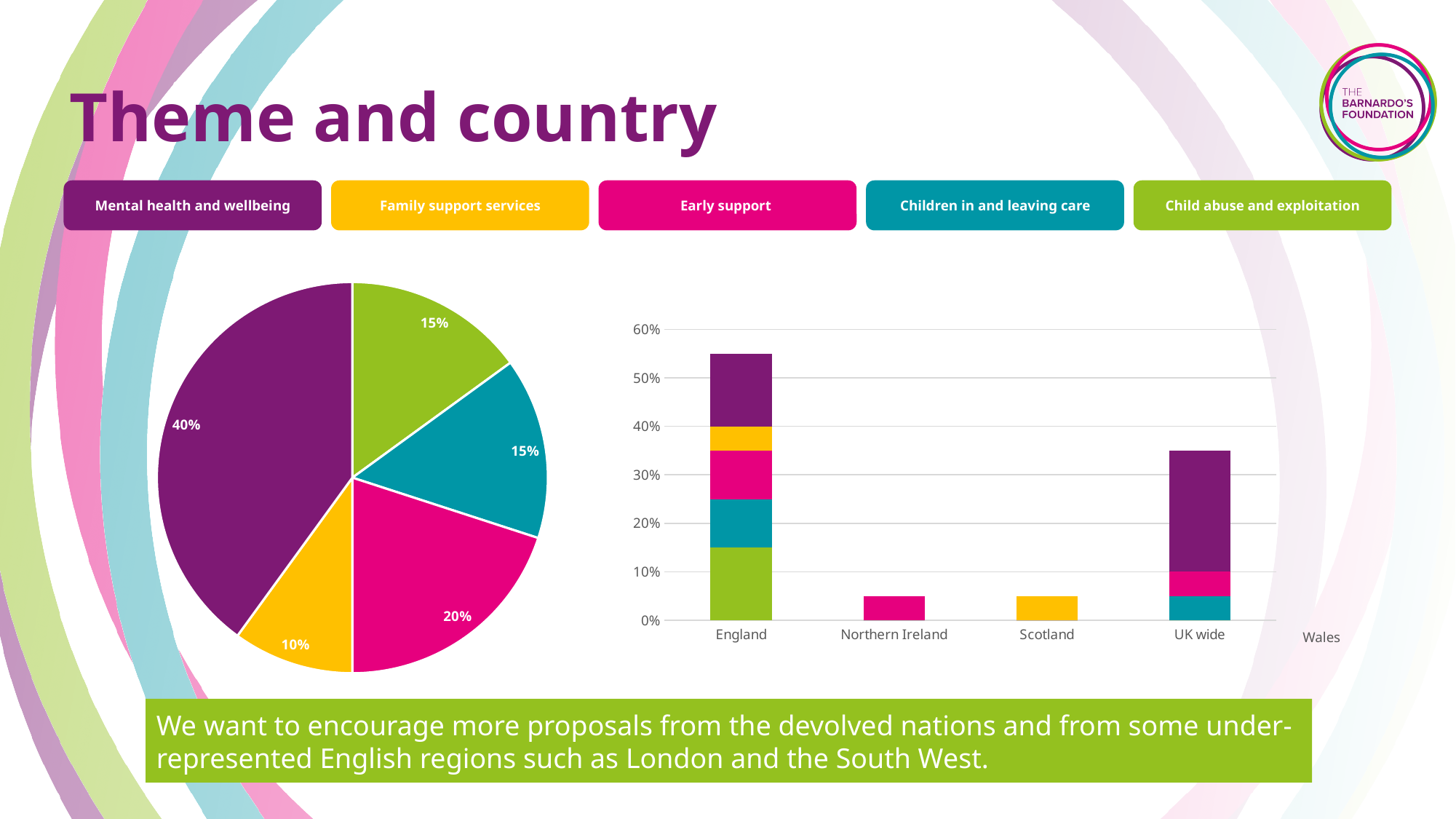
How many slices does the pie chart have? 5 In the pie chart, what share is shown for the purple slice (Mental health and wellbeing)? 40% How many countries are listed on the x axis of the bar chart on the right? 5 In the bar chart on the right, is the total for England greater or less than 50%? greater In the bar chart on the right, is the total for UK wide greater or less than 40%? less In the pie chart, which theme has the smallest share? Family support services In the pie chart, what share is shown for the yellow slice (Family support services)? 10% In the bar chart on the right, which country has the tallest bar? England In the pie chart, what is the difference between the Mental health and wellbeing share and the Early support share? 20% What kind of chart is the chart on the right of the slide? Stacked bar chart In the pie chart, which theme has the largest share? Mental health and wellbeing In the pie chart, what share is shown for the pink slice (Early support)? 20%